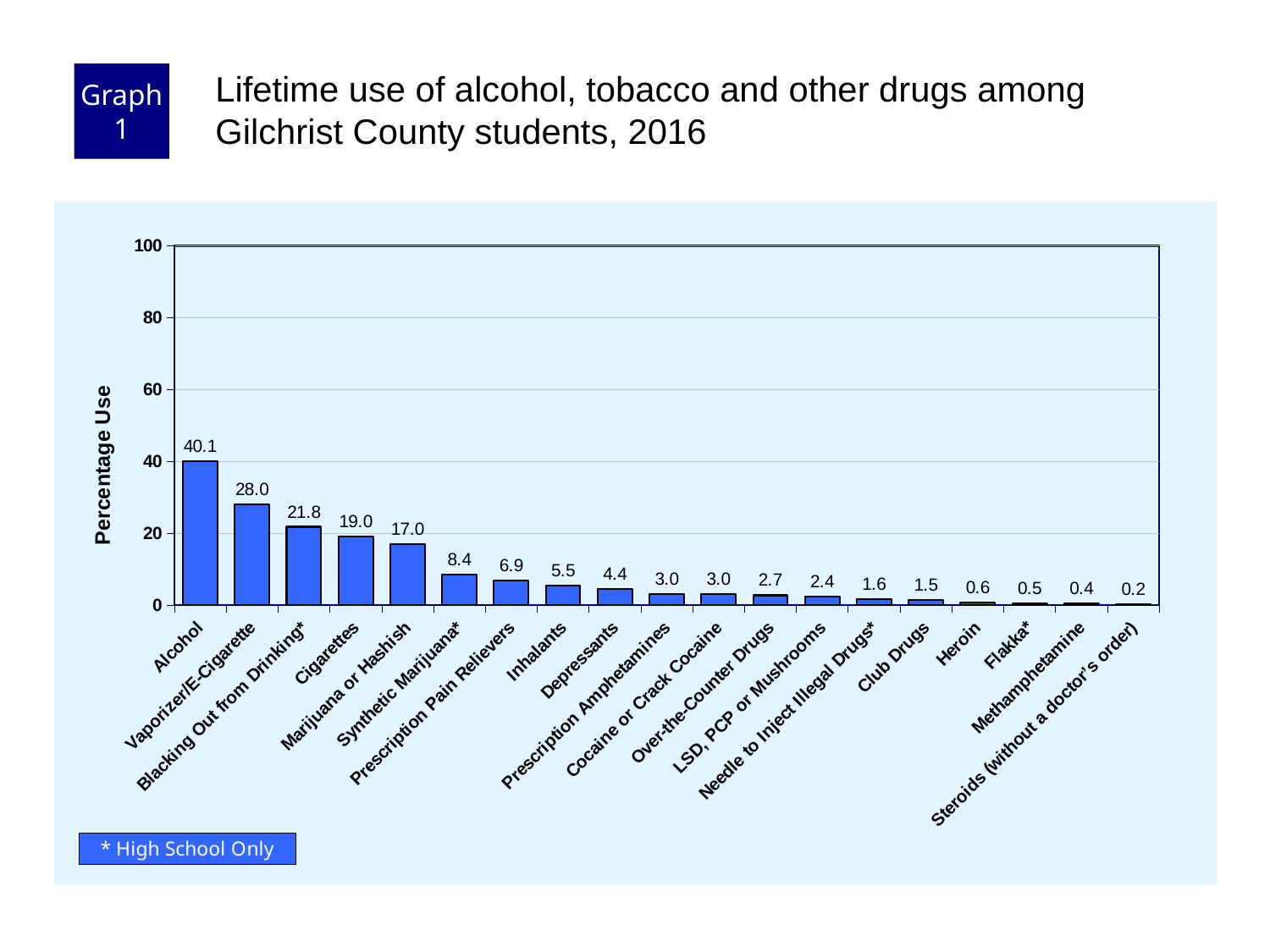
What is the label of the y axis? Percentage Use What is the percentage use for Inhalants? 5.5 Which category has the lowest percentage use? Steroids (without a doctor's order) What kind of chart is shown on the slide? Bar chart Which category has the highest percentage use? Alcohol Which has a higher percentage use, Marijuana or Hashish or Synthetic Marijuana*? Marijuana or Hashish How many categories are shown on the chart? 19 What is the percentage use for Alcohol? 40.1 What is the percentage use for Cigarettes? 19.0 Do the values rise or fall from left to right along the x axis? Fall What is the difference in percentage use between Alcohol and Vaporizer/E-Cigarette? 12.1 Is the value for Blacking Out from Drinking* greater or less than 20? greater